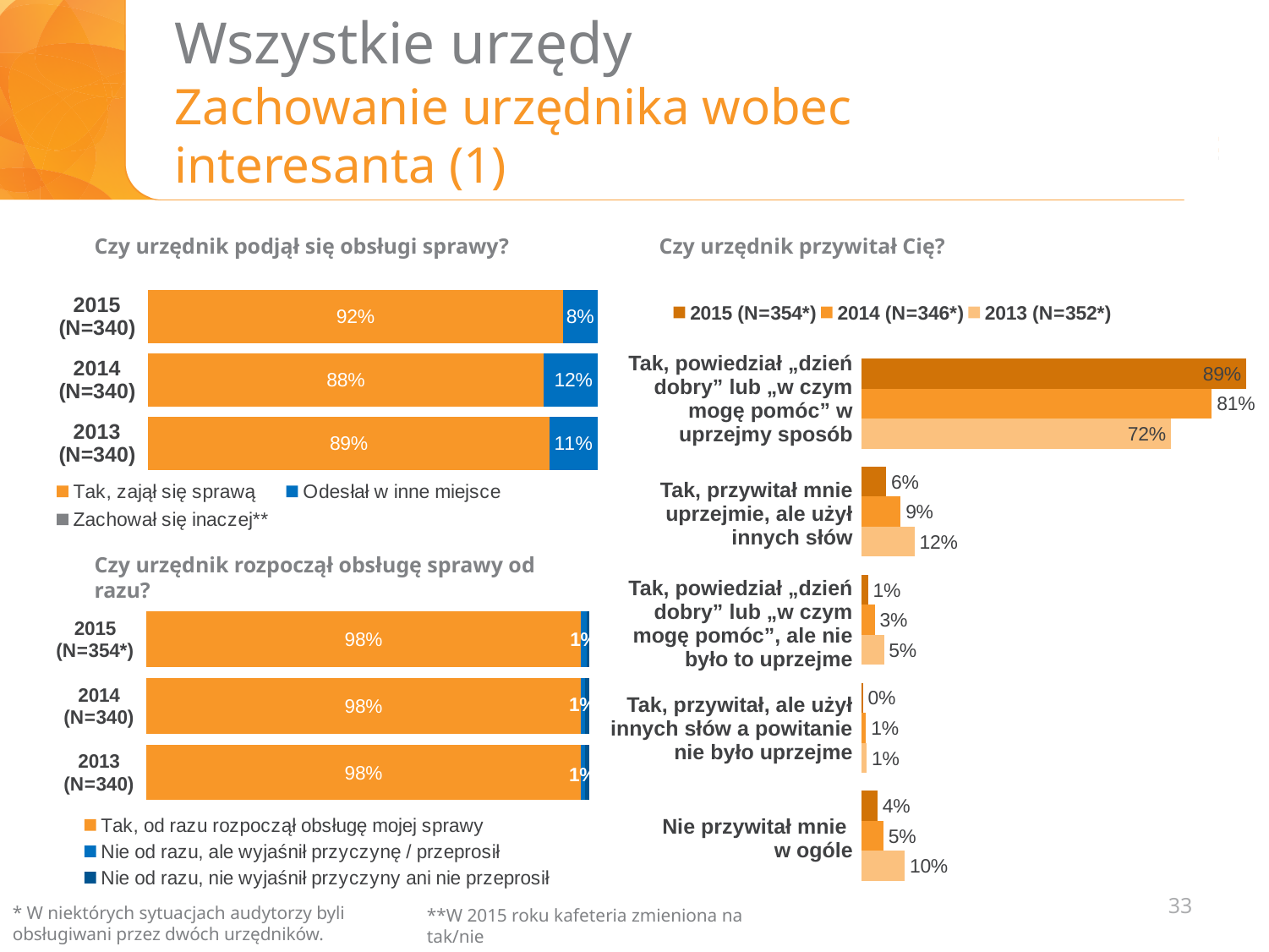
In the chart "Czy urzędnik rozpoczął obsługę sprawy od razu?", what percentage is shown for "Tak, od razu rozpoczął obsługę mojej sprawy" in 2013 (N=340)? 98% In the chart "Czy urzędnik przywitał Cię?", how many response categories are shown? 5 In the chart "Czy urzędnik podjął się obsługi sprawy?", which year has the highest share for "Tak, zajął się sprawą"? 2015 (N=340) In the chart "Czy urzędnik przywitał Cię?", which is larger for "Tak, przywitał mnie uprzejmie, ale użył innych słów": the 2015 value or the 2013 value? 2013 (12%) What type of chart is "Czy urzędnik przywitał Cię?"? bar chart In the chart "Czy urzędnik podjął się obsługi sprawy?", what percentage is shown for "Tak, zajął się sprawą" in 2015 (N=340)? 92% How many legend entries does the chart "Czy urzędnik rozpoczął obsługę sprawy od razu?" list? 3 In the chart "Czy urzędnik przywitał Cię?", what is the 2015 (N=354*) value for "Nie przywitał mnie w ogóle"? 4% In the chart "Czy urzędnik podjął się obsługi sprawy?", what is the difference between the "Tak, zajął się sprawą" values for 2015 and 2014? 4 percentage points In the chart "Czy urzędnik podjął się obsługi sprawy?", what percentage is shown for "Odesłał w inne miejsce" in 2014 (N=340)? 12% In the chart "Czy urzędnik przywitał Cię?", does the value for "Tak, powiedział „dzień dobry” lub „w czym mogę pomóc” w uprzejmy sposób" rise or fall from 2013 to 2015? rise In the chart "Czy urzędnik przywitał Cię?", what is the 2013 (N=352*) value for "Tak, powiedział „dzień dobry” lub „w czym mogę pomóc” w uprzejmy sposób"? 72%